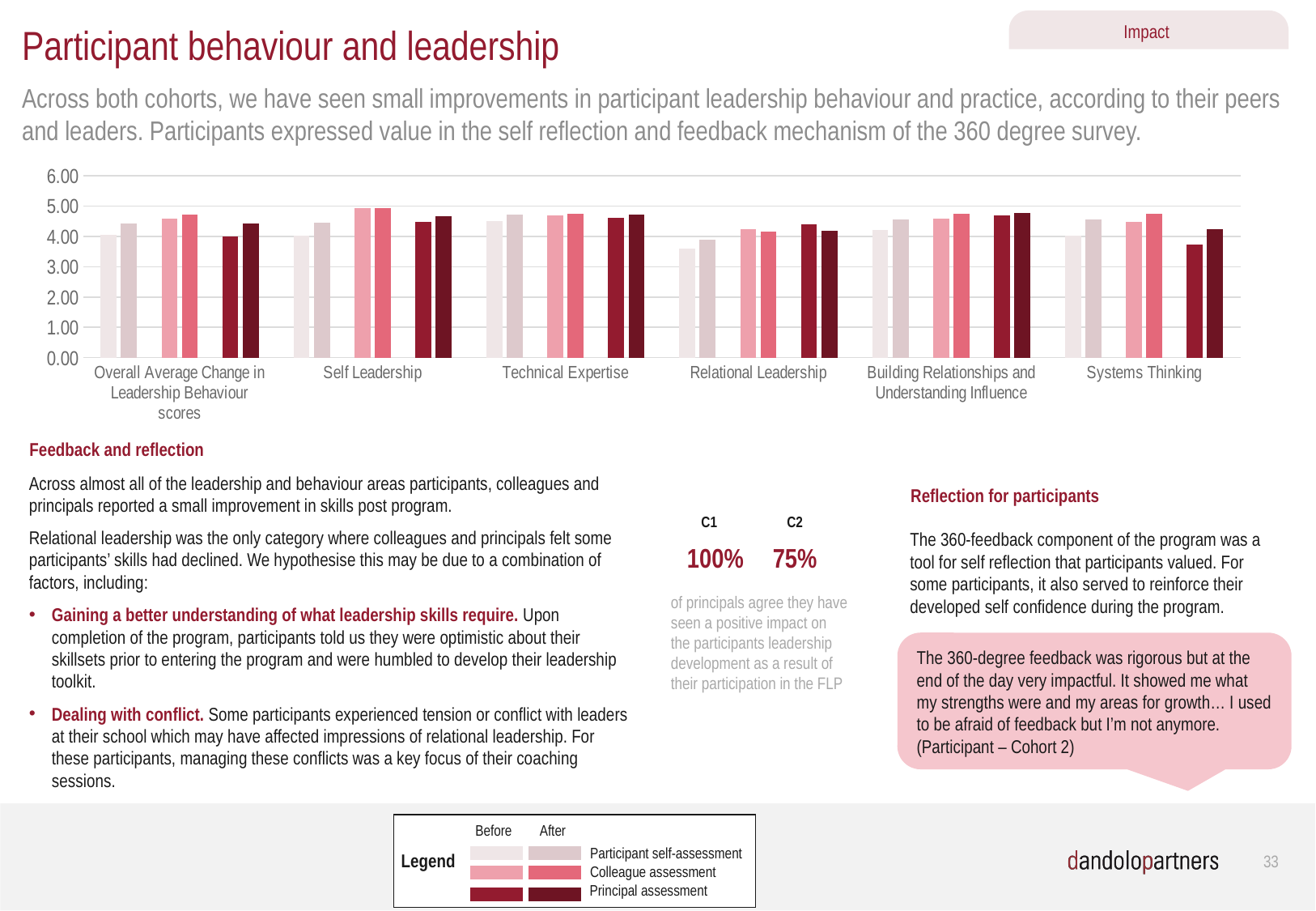
What is the highest value shown on the chart's vertical axis? 6.00 For Systems Thinking, which is larger: the 'Before' or the 'After' principal assessment value? After Is the 'Before' principal assessment value for Systems Thinking greater or less than 4.00? less How many assessment types does the legend list? 3 What kind of chart is shown on the slide? bar chart How many categories are shown along the x axis of the chart? 6 Which assessment type is shown in the darkest red bars according to the legend? Principal assessment For Relational Leadership, which is larger: the 'Before' or the 'After' principal assessment value? Before Is the 'Before' colleague assessment value for Self Leadership greater or less than 4.00? greater Is the 'Before' participant self-assessment value for Relational Leadership greater or less than 4.00? less How many bars are plotted for each category in the chart? 6